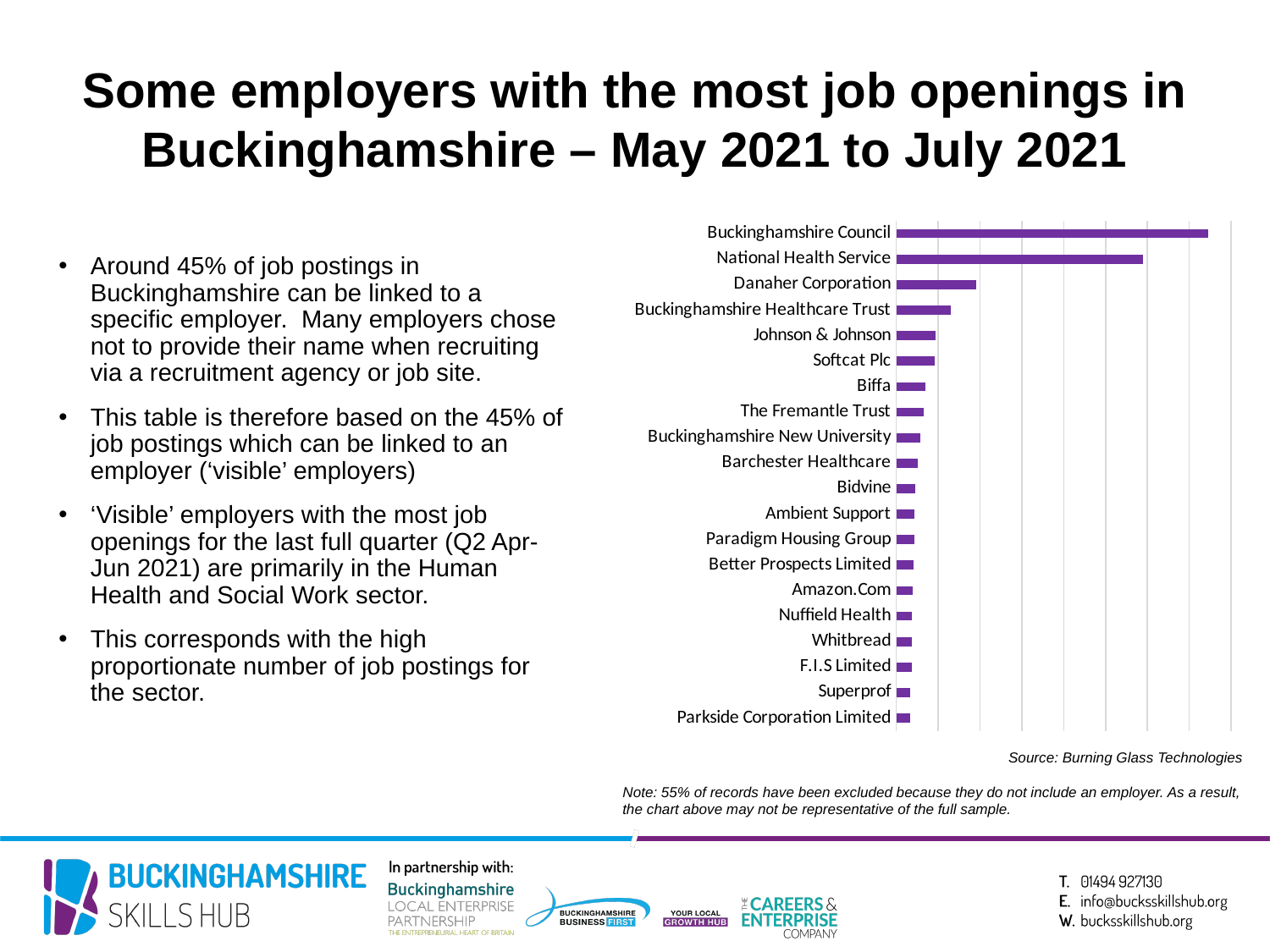
Which employer has the second-longest bar in the chart? National Health Service Which has more job openings, National Health Service or Danaher Corporation? National Health Service What kind of chart is shown on the slide? bar chart Which has more job openings, Softcat Plc or Whitbread? Softcat Plc Which has more job openings, Danaher Corporation or Buckinghamshire Healthcare Trust? Danaher Corporation What is the source cited for the chart? Burning Glass Technologies Are the bars in the chart ordered from largest to smallest or from smallest to largest going down the chart? largest to smallest What colour are the bars in the chart? purple Which employer has the most job openings in the chart? Buckinghamshire Council How many employers are listed in the chart? 20